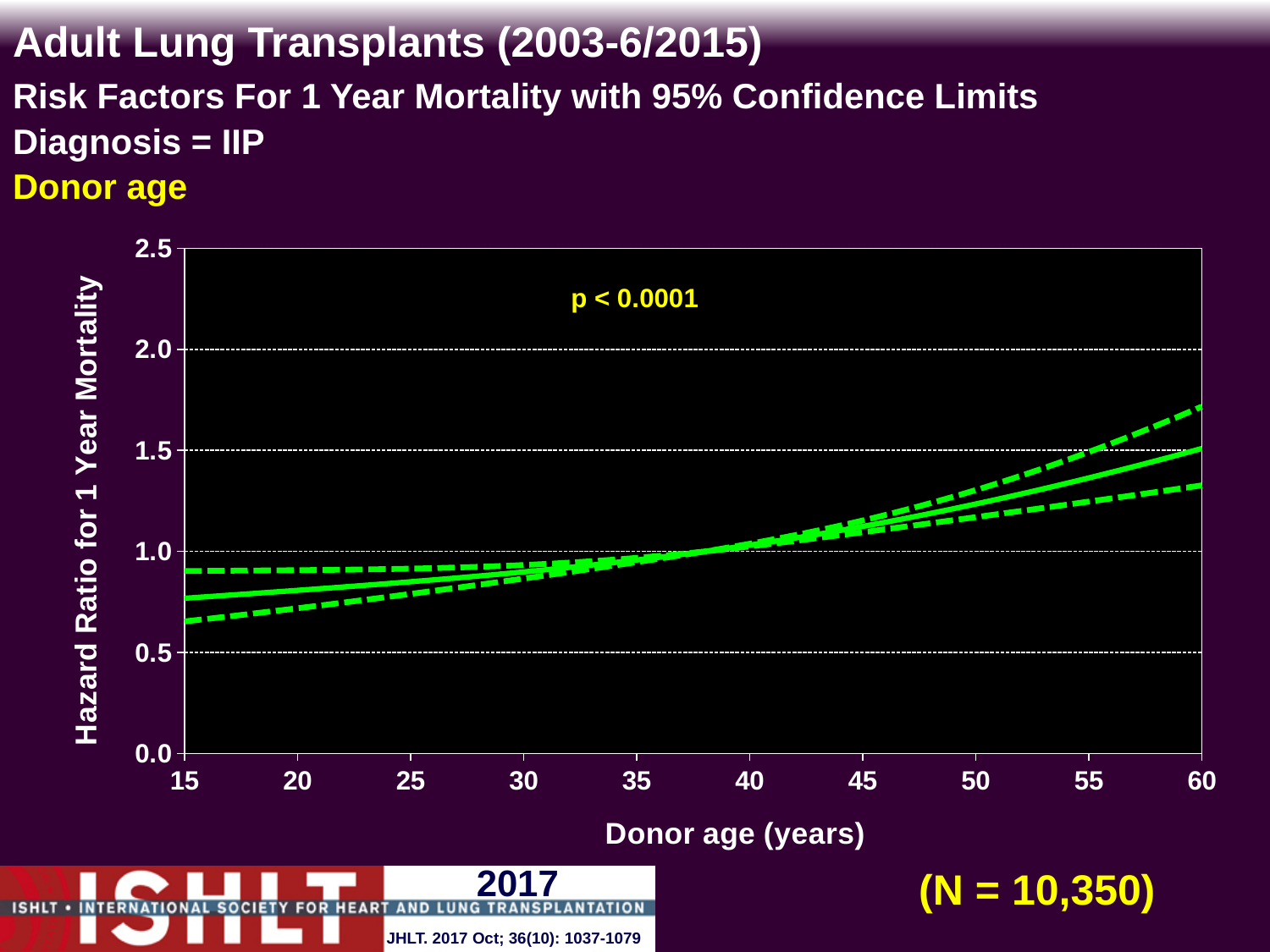
Is the hazard ratio (solid line) at a donor age of 15 years greater or less than 1.0? less What p-value is printed on the chart? p < 0.0001 Is the upper 95% confidence limit at a donor age of 60 years greater or less than 1.5? greater What kind of chart is shown on the slide? line chart Is the lower 95% confidence limit at a donor age of 60 years greater or less than 1.5? less Which is larger, the hazard ratio at a donor age of 20 years or at a donor age of 55 years? 55 years How many tick labels are shown on the x axis? 10 What is the label of the x axis? Donor age (years) What is the maximum value shown on the y axis? 2.5 Does the hazard ratio for 1 year mortality rise or fall as donor age increases from 15 to 60 years? rise